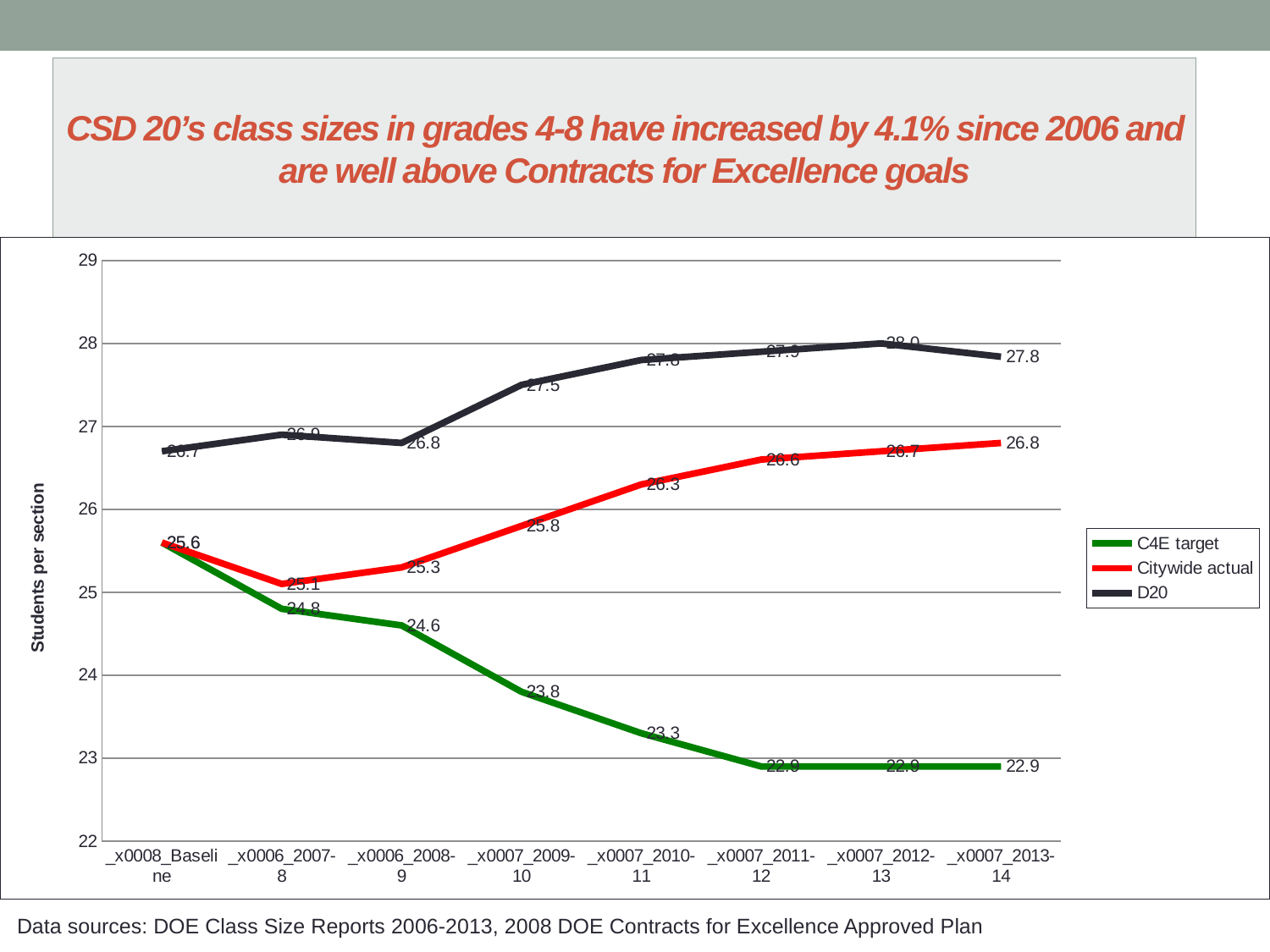
How many points along the x axis does each line have? 8 What is the C4E target value for 2013-14? 22.9 Which is larger in 2009-10, the D20 value or the Citywide actual value? D20 What is the Citywide actual value for 2013-14? 26.8 What is the C4E target value for 2009-10? 23.8 What is the D20 value for 2013-14? 27.8 Is the D20 value at Baseline greater or less than 27? less How many series does the legend list? 3 What is the difference between the D20 and Citywide actual values in 2013-14? 1.0 What kind of chart is shown on the slide? line chart What is the label on the vertical axis? Students per section Does the C4E target line rise or fall from Baseline to 2013-14? fall